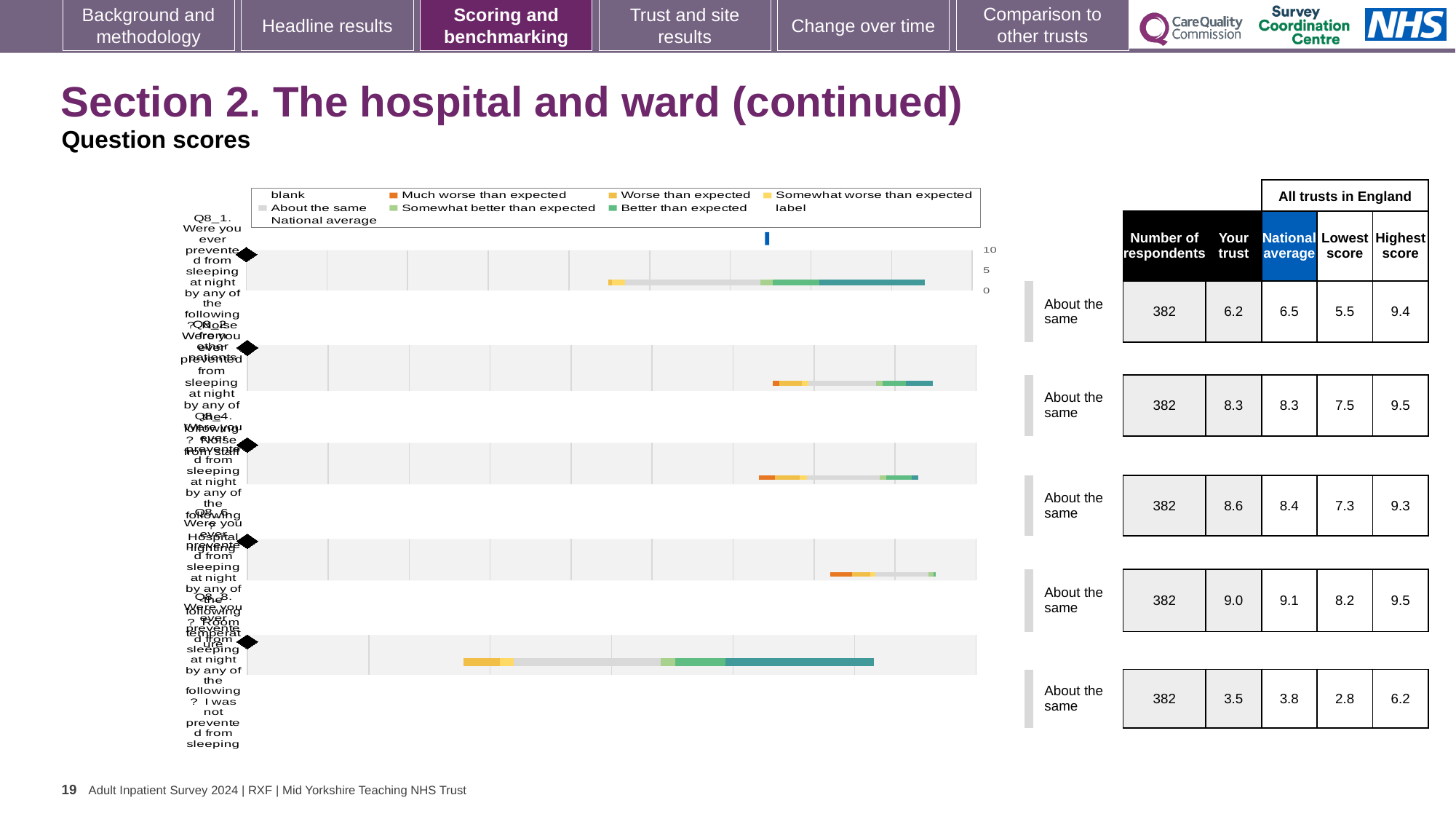
In the table beside the chart, which row has the lowest 'Your trust' score? Q8_8 (3.5) In the table beside the chart, which row has the highest 'Your trust' score? Q8_6 (9.0) In the table beside the chart, what is the national average for the last row (Q8_8)? 3.8 What is the highest value shown on the chart's axis? 10 How many horizontal bars (questions) are plotted in the chart? 5 Which legend entry is shown in orange in the chart's legend? Much worse than expected In the table beside the chart, what is the difference between the highest score and lowest score for the Q8_2 row? 2.0 What benchmark category is shown for every question on the slide? About the same In the table beside the chart, what is the 'Your trust' score for the first row (Q8_1)? 6.2 How many respondents are listed for each question in the table beside the chart? 382 In the table beside the chart, is the 'Your trust' score for Q8_4 larger or smaller than its national average? larger What kind of chart is shown on the slide? bar chart